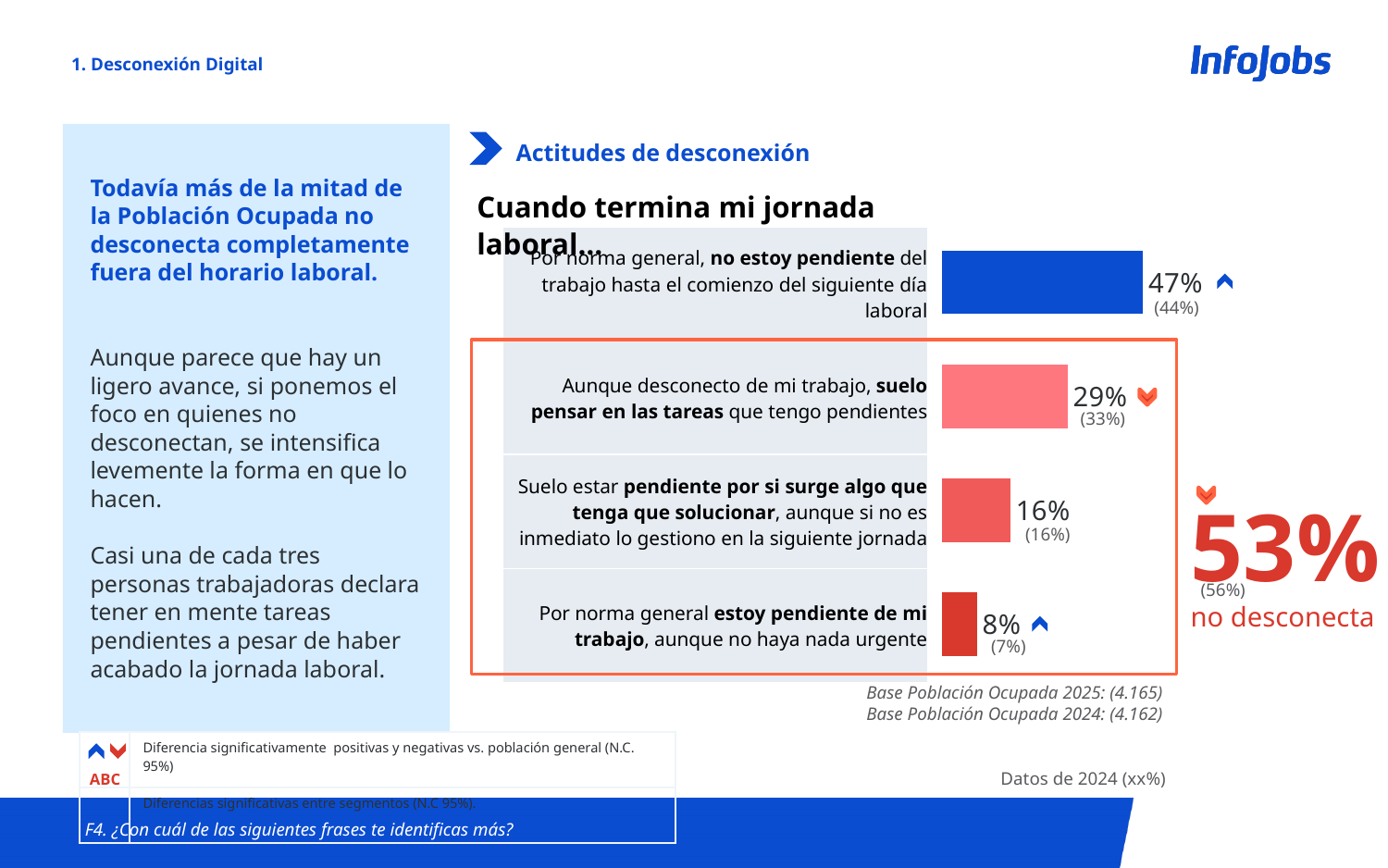
What is the 2025 value for "Aunque desconecto de mi trabajo, suelo pensar en las tareas que tengo pendientes"? 29% What was the 2024 value (shown in parentheses) for "Aunque desconecto de mi trabajo, suelo pensar en las tareas que tengo pendientes"? 33% What is the 2025 value for "Suelo estar pendiente por si surge algo que tenga que solucionar, aunque si no es inmediato lo gestiono en la siguiente jornada"? 16% What is the 2024 value shown in parentheses under the 53% "no desconecta" figure? 56% What is the 2025 value for "Por norma general estoy pendiente de mi trabajo, aunque no haya nada urgente"? 8% How many categories (statements) does the bar chart show? 4 Which statement has the lowest 2025 value? Por norma general estoy pendiente de mi trabajo, aunque no haya nada urgente What is the difference between the 2025 values for "no estoy pendiente del trabajo" (47%) and "suelo pensar en las tareas" (29%)? 18% What kind of chart is shown on the slide? bar chart What percentage of the Población Ocupada in 2025 does the slide say does not disconnect ("no desconecta")? 53% Which statement has the highest 2025 value? Por norma general, no estoy pendiente del trabajo hasta el comienzo del siguiente día laboral What is the 2025 value for "Por norma general, no estoy pendiente del trabajo hasta el comienzo del siguiente día laboral"? 47%